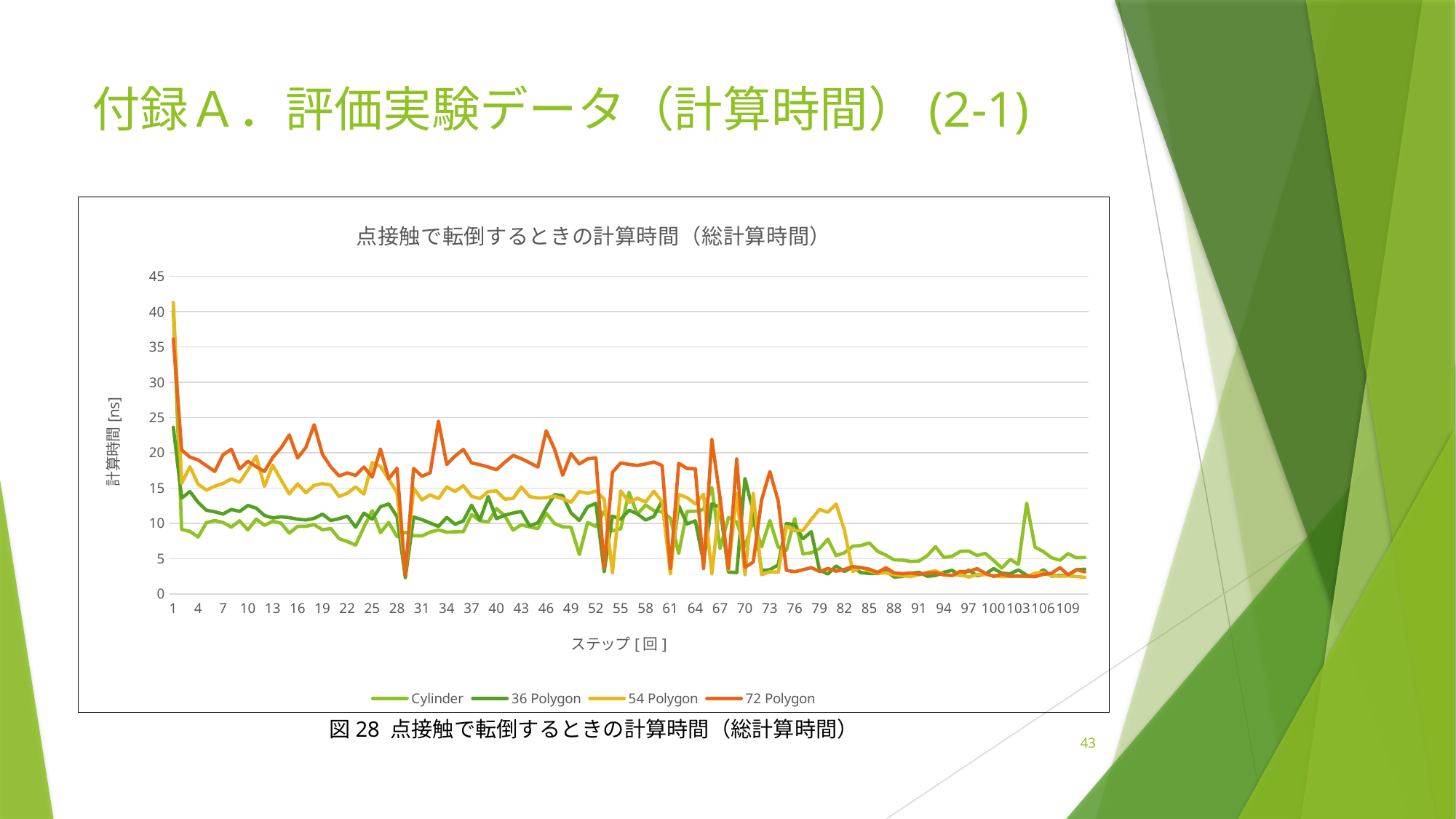
What is the title of the chart? 点接触で転倒するときの計算時間（総計算時間） Which series reaches the highest value on the chart? 54 Polygon At step 1, which is larger: the value for 54 Polygon or the value for 36 Polygon? 54 Polygon Is the value for 72 Polygon at step 1 greater or less than 30? greater What kind of chart is shown on the slide? line chart Is the value for 36 Polygon at step 1 greater or less than 20? greater Do the values generally rise or fall as the step number increases? fall What is the label of the vertical axis? 計算時間 [ns] How many series does the legend list? 4 Is the value for 72 Polygon at step 109 greater or less than 5? less